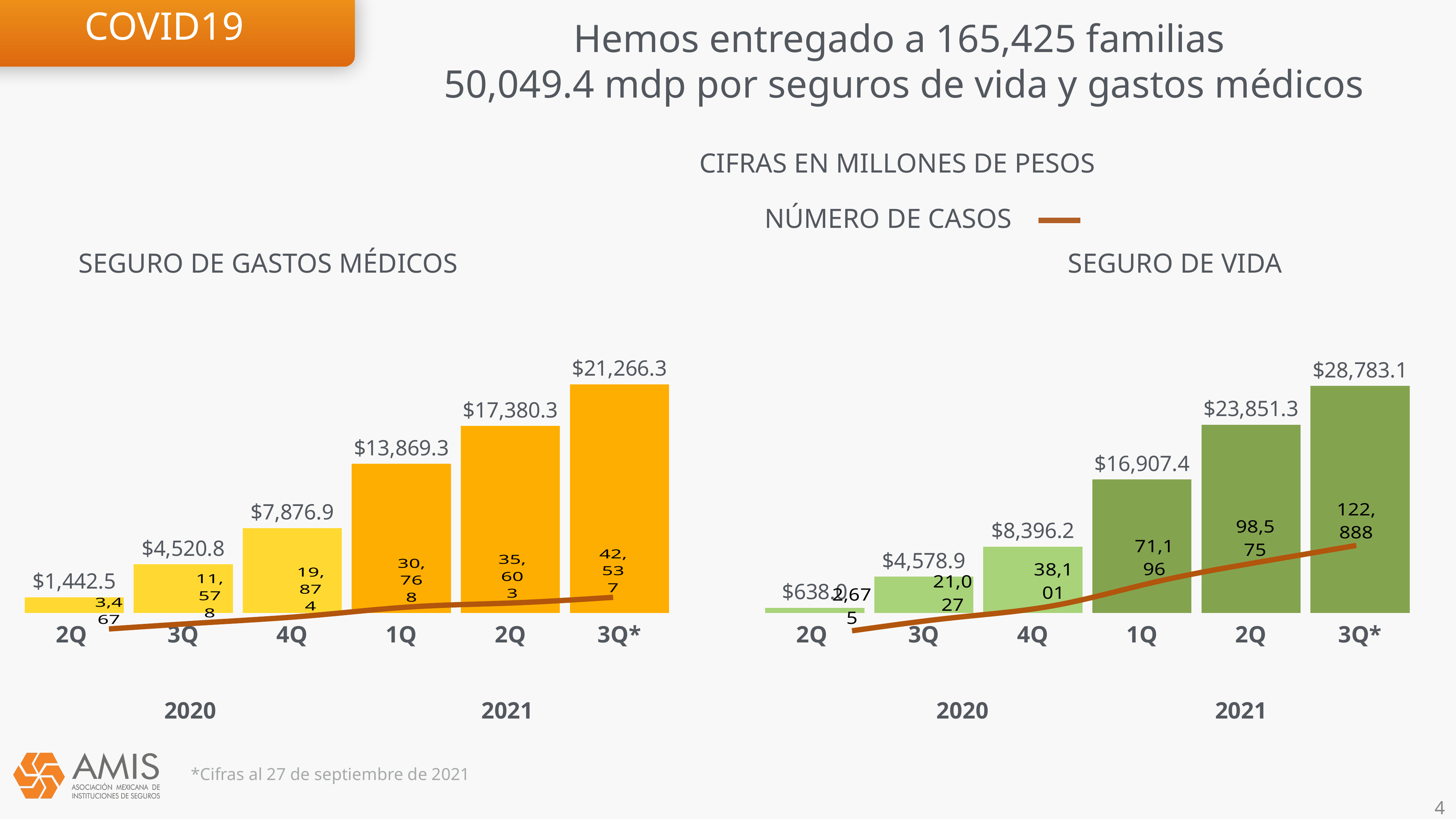
In the SEGURO DE GASTOS MÉDICOS chart, what is the value of the bar for 3Q* 2021? $21,266.3 Which is larger: the 3Q* 2021 bar in the SEGURO DE VIDA chart or the 3Q* 2021 bar in the SEGURO DE GASTOS MÉDICOS chart? SEGURO DE VIDA In the SEGURO DE VIDA chart, what is the value of the bar for 3Q 2020? $4,578.9 In the SEGURO DE GASTOS MÉDICOS chart, do the bar values rise or fall from 2Q 2020 to 3Q* 2021? Rise In the SEGURO DE GASTOS MÉDICOS chart, which quarter has the lowest bar? 2Q 2020 In the SEGURO DE VIDA chart, what is the value of the bar for 2Q 2021? $23,851.3 In the SEGURO DE GASTOS MÉDICOS chart, what is the difference between the bars for 2Q 2021 and 1Q 2021? $3,511.0 How many quarters are shown as bars in the SEGURO DE GASTOS MÉDICOS chart? 6 In the SEGURO DE GASTOS MÉDICOS chart, what is the value of the bar for 4Q 2020? $7,876.9 In the SEGURO DE VIDA chart, which quarter has the highest bar? 3Q* 2021 In the SEGURO DE VIDA chart, what is the difference between the bars for 3Q* 2021 and 2Q 2021? $4,931.8 What type of chart is used for the SEGURO DE VIDA data? Bar chart with a line